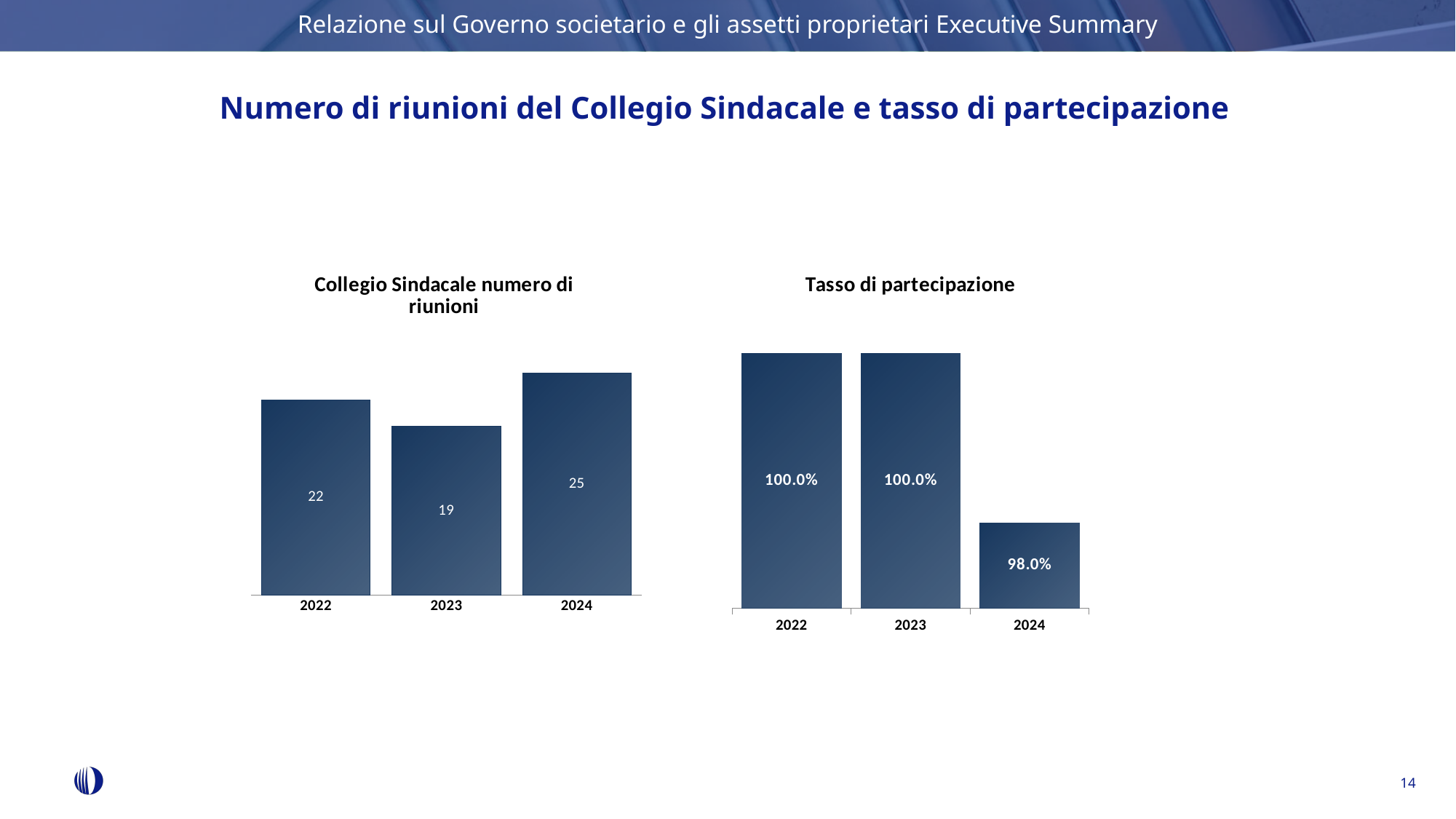
In the 'Collegio Sindacale numero di riunioni' chart, which is larger, the value for 2022 or the value for 2024? 2024 How many categories are shown in the 'Tasso di partecipazione' chart? 3 In the 'Collegio Sindacale numero di riunioni' chart, which year has the lowest value? 2023 In the 'Tasso di partecipazione' chart, what is the value for 2024? 98.0% In the 'Tasso di partecipazione' chart, which year has the lowest value? 2024 In the 'Collegio Sindacale numero di riunioni' chart, which year has the highest value? 2024 In the 'Collegio Sindacale numero di riunioni' chart, what is the difference between the values for 2024 and 2023? 6 In the 'Collegio Sindacale numero di riunioni' chart, what is the value for 2022? 22 What kind of chart is the 'Collegio Sindacale numero di riunioni' chart? bar chart In the 'Tasso di partecipazione' chart, what is the value for 2022? 100.0% In the 'Collegio Sindacale numero di riunioni' chart, what is the value for 2023? 19 In the 'Tasso di partecipazione' chart, what is the difference between the values for 2023 and 2024? 2.0%